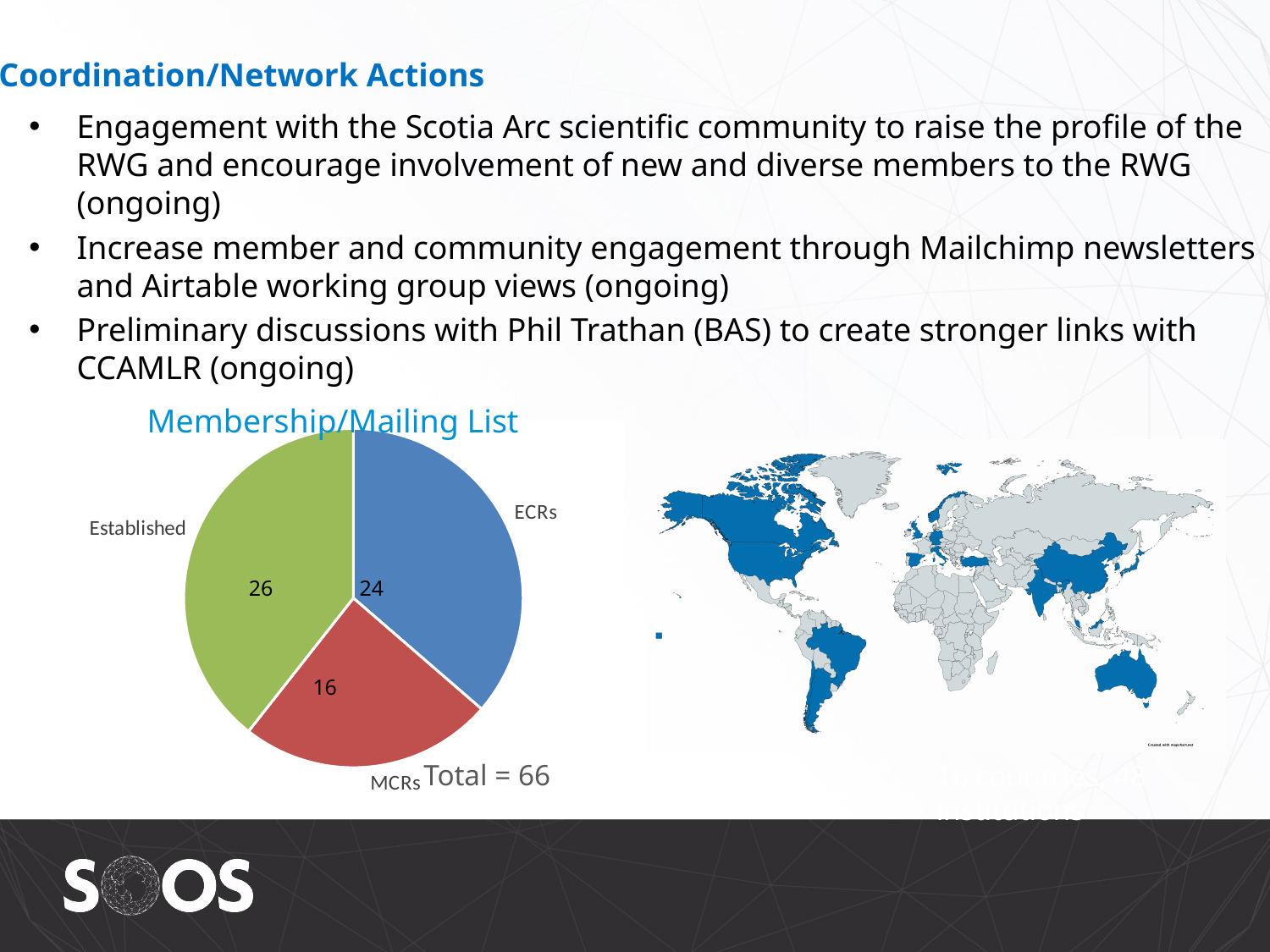
What is the title of the pie chart on the slide? Membership/Mailing List Which category has the smallest slice in the Membership/Mailing List pie chart? MCRs What total is stated for the Membership/Mailing List pie chart? Total = 66 In the Membership/Mailing List pie chart, what colour is the Established slice? green In the Membership/Mailing List pie chart, what is the difference between the Established and MCRs values? 10 In the Membership/Mailing List pie chart, what is the value for Established? 26 How many slices does the Membership/Mailing List pie chart have? 3 Which category has the largest slice in the Membership/Mailing List pie chart? Established In the Membership/Mailing List pie chart, what is the value for MCRs? 16 What type of chart is the Membership/Mailing List chart? pie chart In the Membership/Mailing List pie chart, what is the value for ECRs? 24 In the Membership/Mailing List pie chart, which is larger, ECRs or MCRs? ECRs